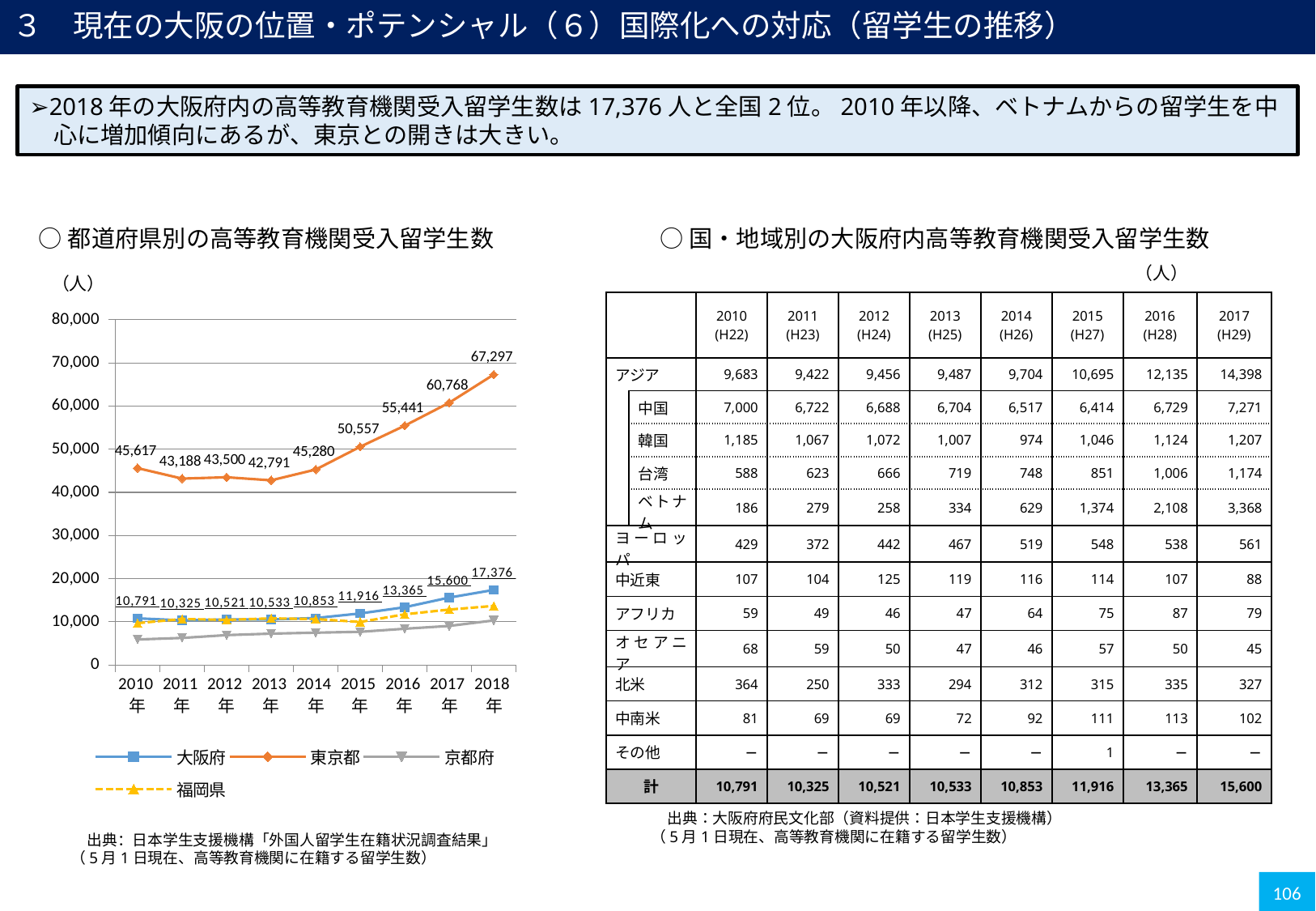
Is the value for 京都府 in 2018年 greater or less than 20,000? less What is the value for 大阪府 in 2016年? 13,365 In which year is the value for 東京都 lowest? 2013年 What is the value for 大阪府 in 2010年? 10,791 What is the difference between the 東京都 and 大阪府 values in 2018年? 49,921 How many years are plotted along the x axis of the chart? 9 What type of chart is shown on the slide? line chart In which year is the value for 大阪府 highest? 2018年 Does the value for 東京都 rise or fall from 2014年 to 2018年? rise Which series has the larger value in 2017年, 東京都 or 大阪府? 東京都 What is the value for 東京都 in 2018年? 67,297 How many series does the chart legend list? 4